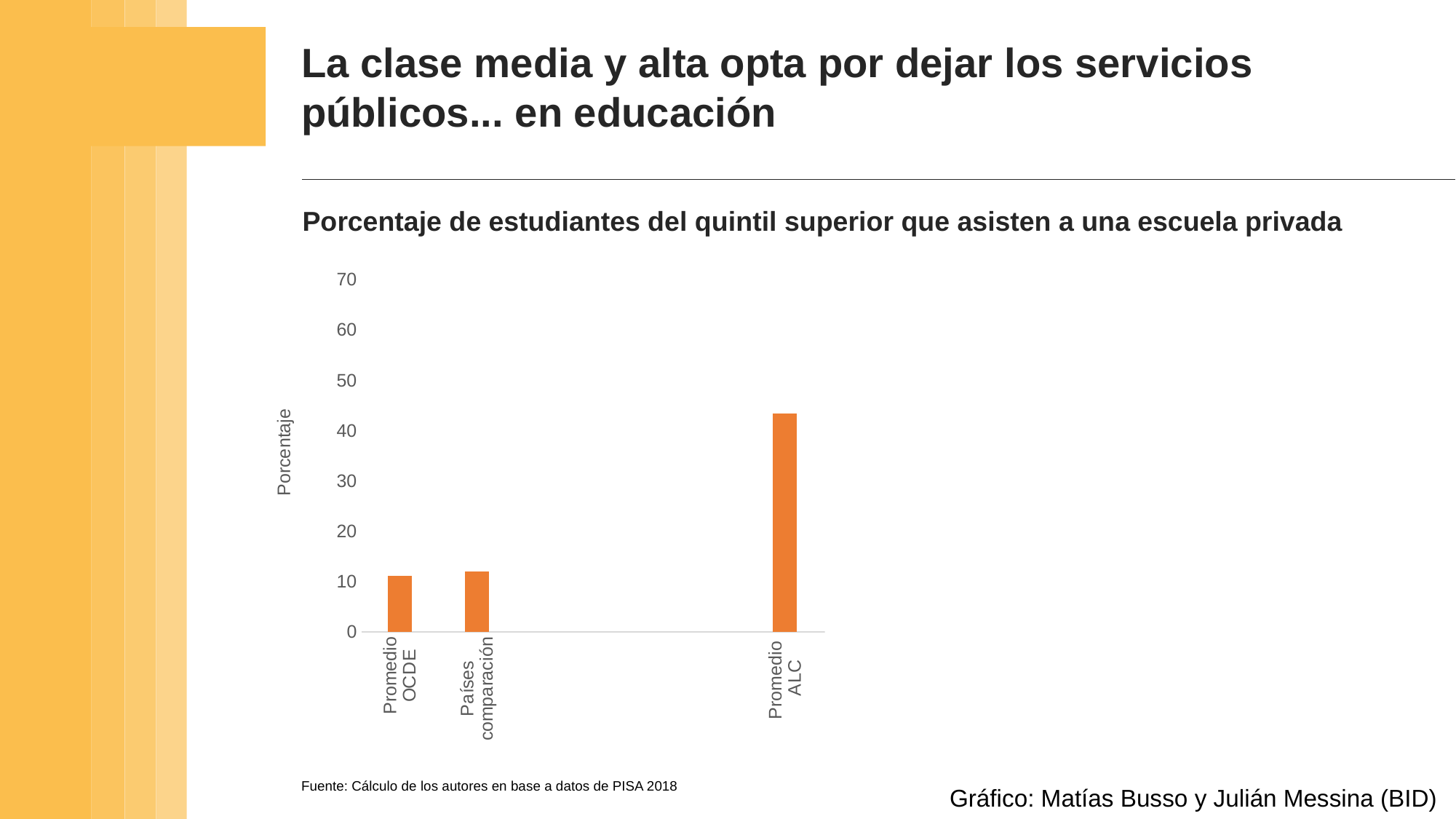
What is the label of the vertical axis of the chart? Porcentaje Which category has the highest value in the chart? Promedio ALC Which is larger, the value for Promedio ALC or the value for Promedio OCDE? Promedio ALC Is the value for Promedio ALC greater or less than 50? less What kind of chart is shown on the slide? bar chart How many categories are plotted on the x axis of the chart? 3 Is the value for Promedio ALC greater or less than 40? greater Is the value for Países comparación greater or less than 10? greater What is the highest tick value shown on the vertical axis of the chart? 70 Which is larger, the value for Países comparación or the value for Promedio ALC? Promedio ALC